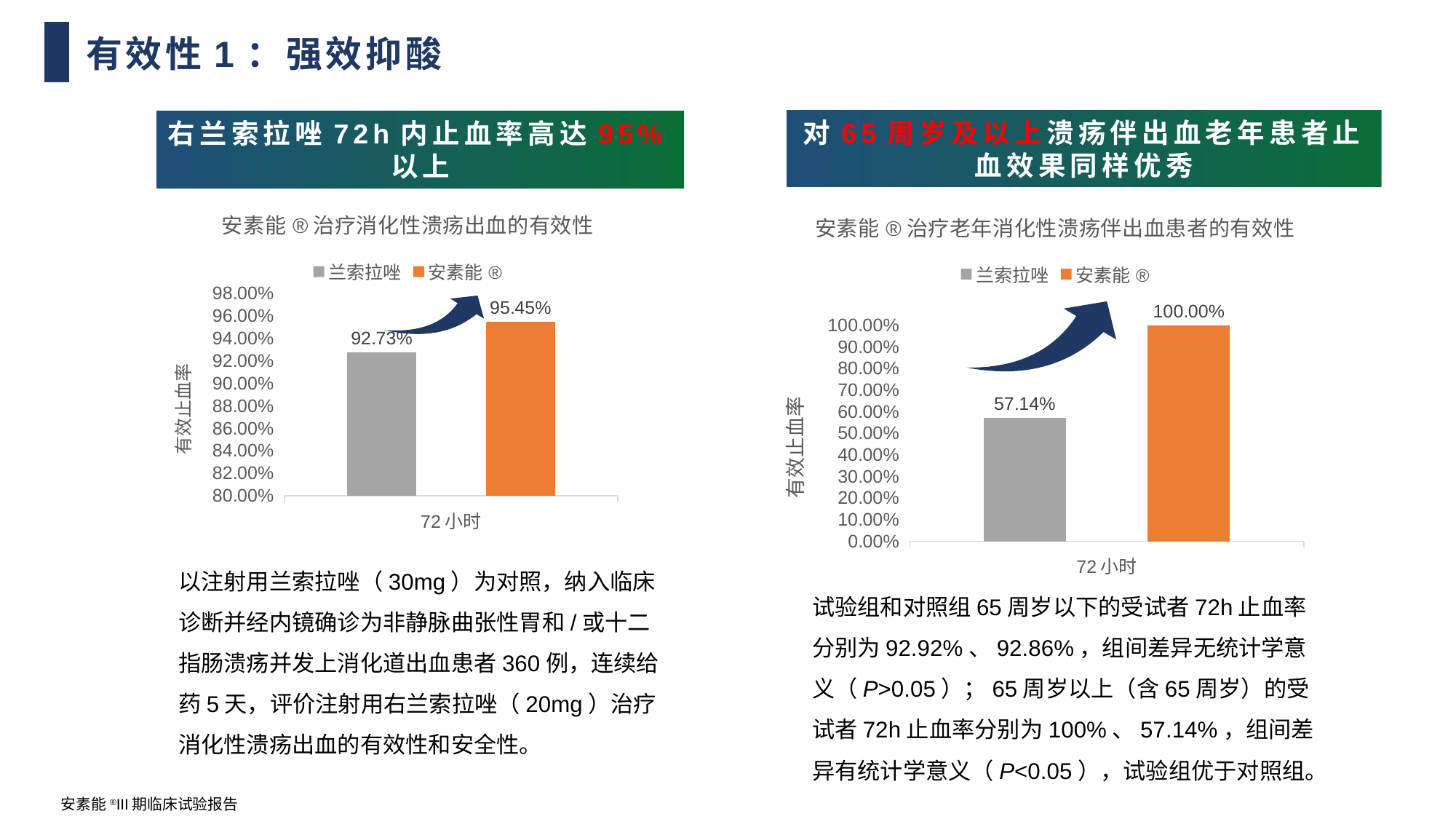
In the left chart (安素能®治疗消化性溃疡出血的有效性), what is the value for 兰索拉唑 at 72小时? 92.73% In the left chart, what is the difference between the 安素能® value and the 兰索拉唑 value? 2.72% In the right chart, what is the difference between the 安素能® value and the 兰索拉唑 value? 42.86% What is the y-axis label of the right chart? 有效止血率 In the right chart, which series has the lowest value? 兰索拉唑 In the left chart, what colour is the bar for 安素能®? Orange In the left chart, which series has the higher value, 兰索拉唑 or 安素能®? 安素能® In the left chart (安素能®治疗消化性溃疡出血的有效性), what is the value for 安素能® at 72小时? 95.45% In the right chart (安素能®治疗老年消化性溃疡伴出血患者的有效性), what is the value for 安素能®? 100.00% In the right chart (安素能®治疗老年消化性溃疡伴出血患者的有效性), what is the value for 兰索拉唑? 57.14% How many series does the legend of the right chart list? 2 What kind of chart is the left chart? Bar chart